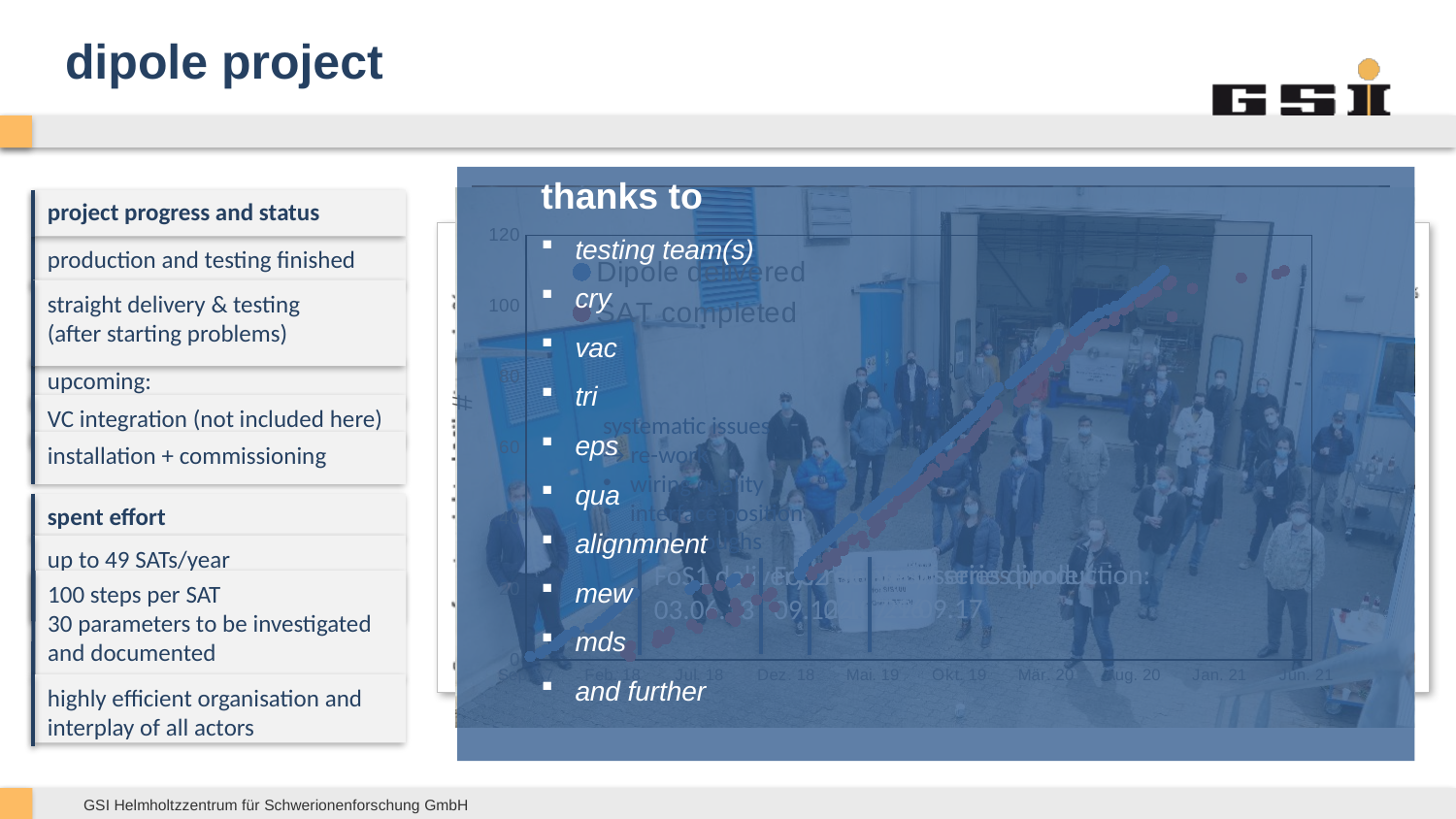
What kind of chart is shown on the slide? scatter chart What are the two series named in the chart legend? Dipole delivered and SAT completed Do the plotted values rise or fall along the x axis from Sep. 17 to Jun. 21? rise What is the highest tick value shown on the chart's y axis? 120 Is the value of the Dipole delivered series at the right end of the chart greater or less than 60? greater How many series does the chart legend list? 2